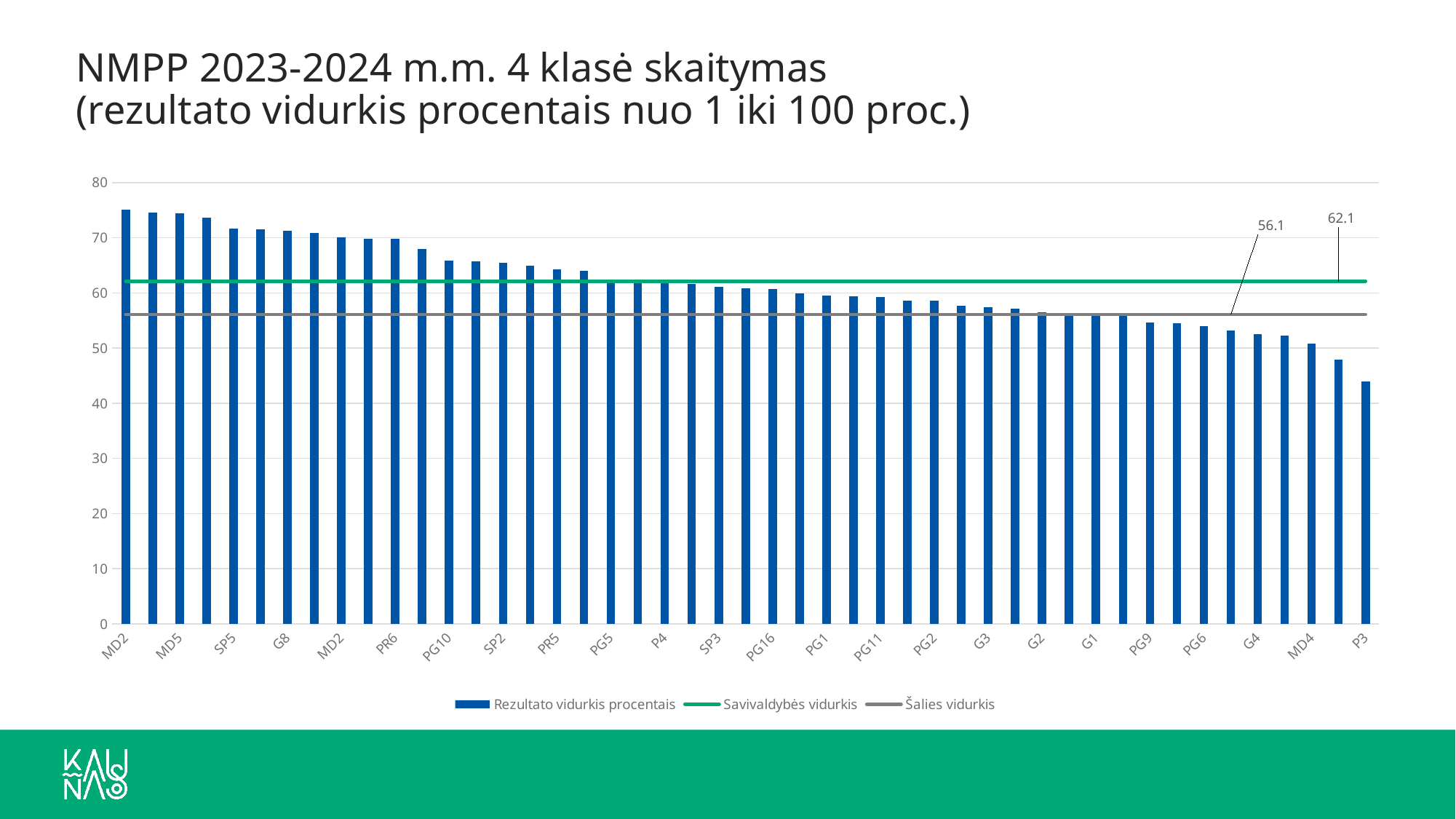
Is the value for P3 greater or less than 50? less Which is higher, the Savivaldybės vidurkis or the Šalies vidurkis? Savivaldybės vidurkis What is the value of the Savivaldybės vidurkis line? 62.1 Is the value for G4 greater or less than 60? less Which labelled category has the lowest bar? P3 What colour is the Savivaldybės vidurkis line in the legend? green How many series does the legend list? 3 Do the bar values rise or fall from left to right along the x axis? fall What kind of chart is shown on the slide? bar chart What is the difference between the Savivaldybės vidurkis (62.1) and the Šalies vidurkis (56.1)? 6 What is the value of the Šalies vidurkis line? 56.1 Is the value for PG10 greater or less than 60? greater